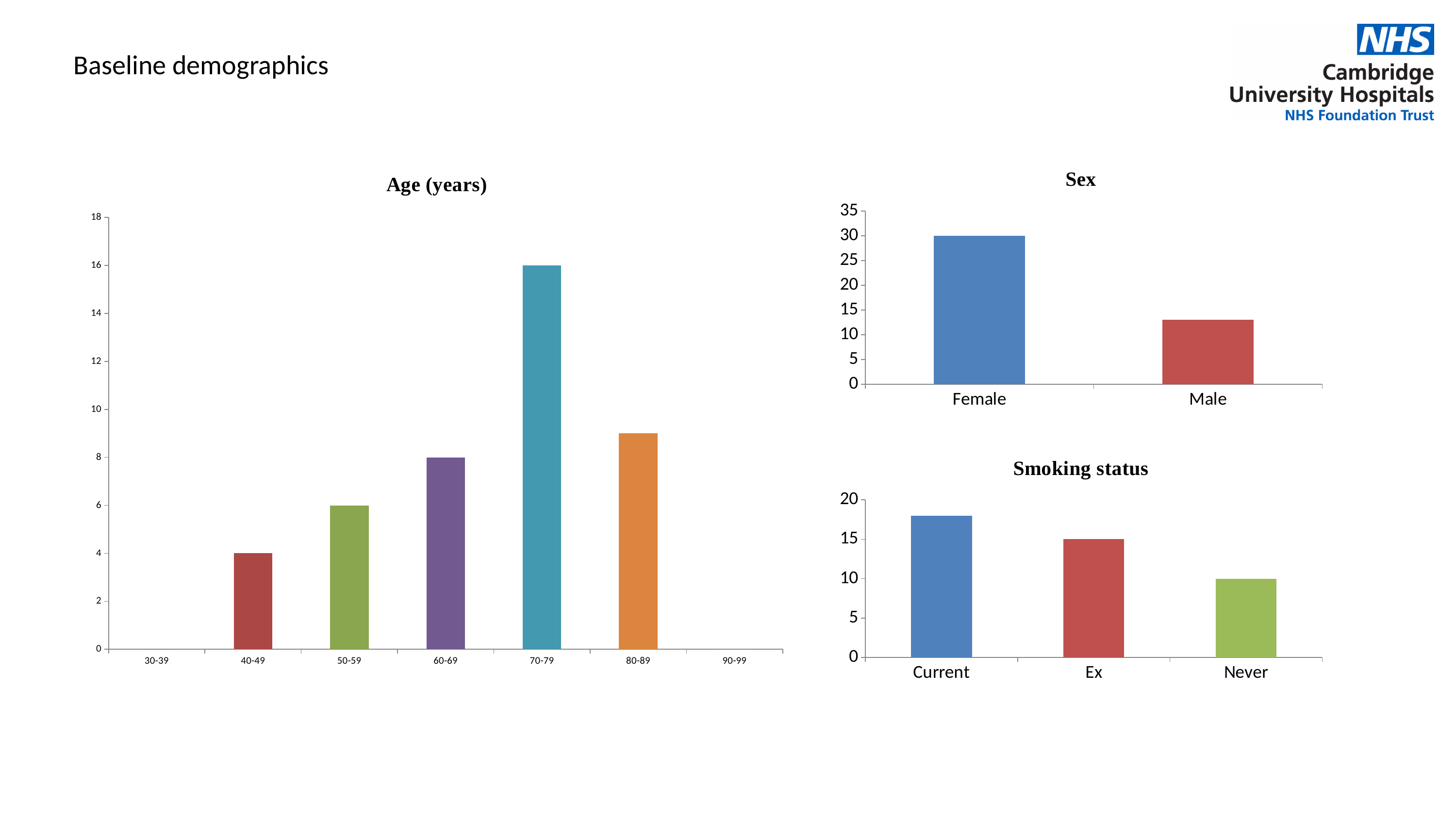
In the Age (years) chart, is the value for 80-89 greater or less than 10? less How many categories are shown on the x axis of the Smoking status chart? 3 In the Smoking status chart, what is the value for Ex? 15 In the Age (years) chart, what is the difference between the values for 70-79 and 60-69? 8 In the Sex chart, what is the value for Female? 30 In the Smoking status chart, what is the difference between the values for Ex and Never? 5 In the Age (years) chart, which age group has the highest value? 70-79 In the Smoking status chart, which category has the lowest value? Never In the Age (years) chart, what is the value for the 70-79 age group? 16 In the Sex chart, is the value for Male greater or less than 15? less In the Age (years) chart, what is the value for the 60-69 age group? 8 In the Age (years) chart, what is the value for the 40-49 age group? 4